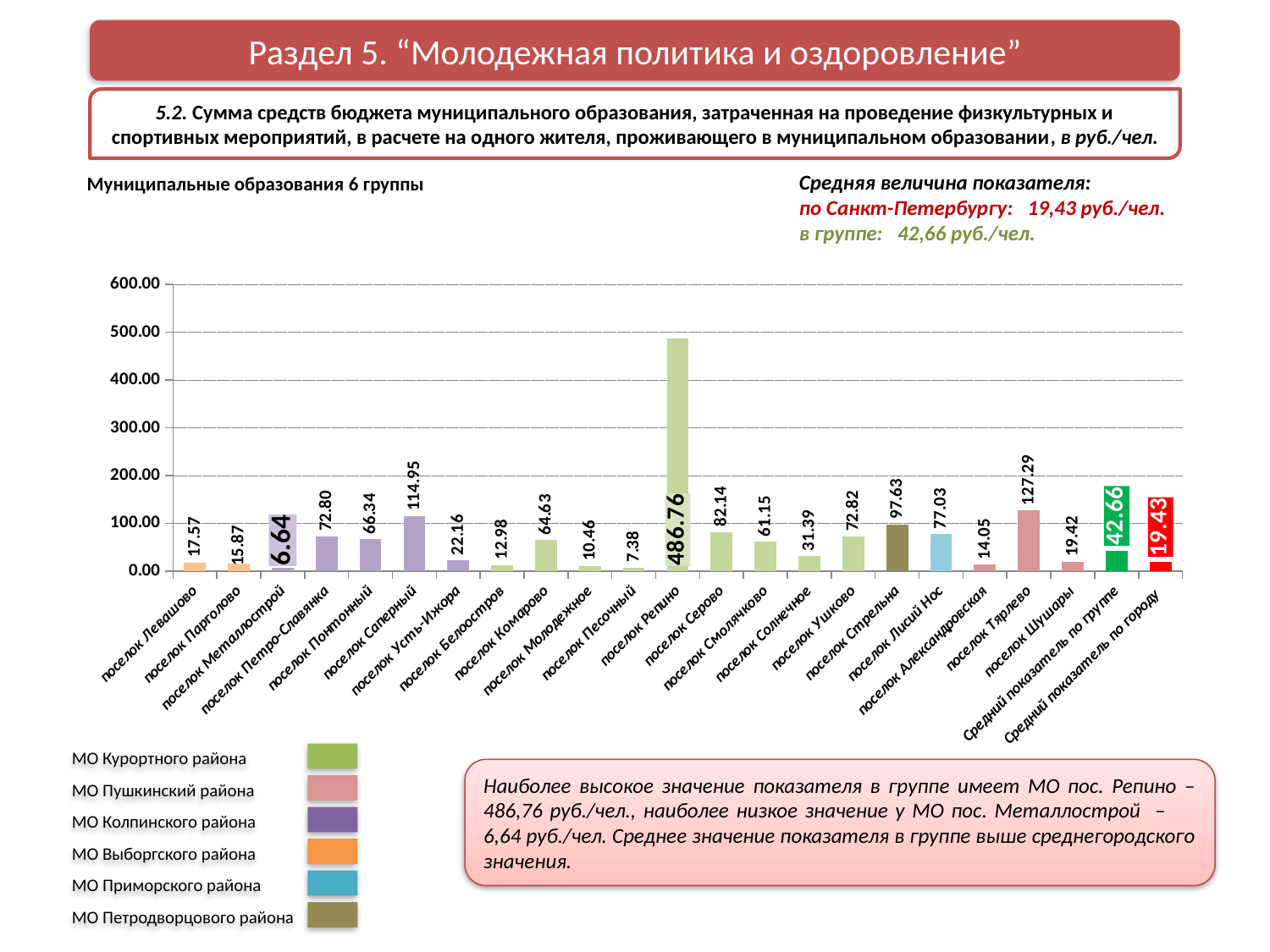
What is the value for поселок Тярлево? 127.29 Is the value for поселок Репино greater or less than 400.00? greater How many bars are plotted in the chart? 23 What type of chart is shown on the slide? bar chart What is the value for поселок Репино? 486.76 How many district entries does the legend below the chart list? 6 What is the value shown for Средний показатель по группе? 42.66 What is the value for поселок Стрельна? 97.63 What is the difference between the values for поселок Саперный and поселок Петро-Славянка? 42.15 Which category has the lowest value in the chart? поселок Металлострой Which category has the highest value in the chart? поселок Репино Which is larger, the value for поселок Серово or the value for поселок Лисий Нос? поселок Серово